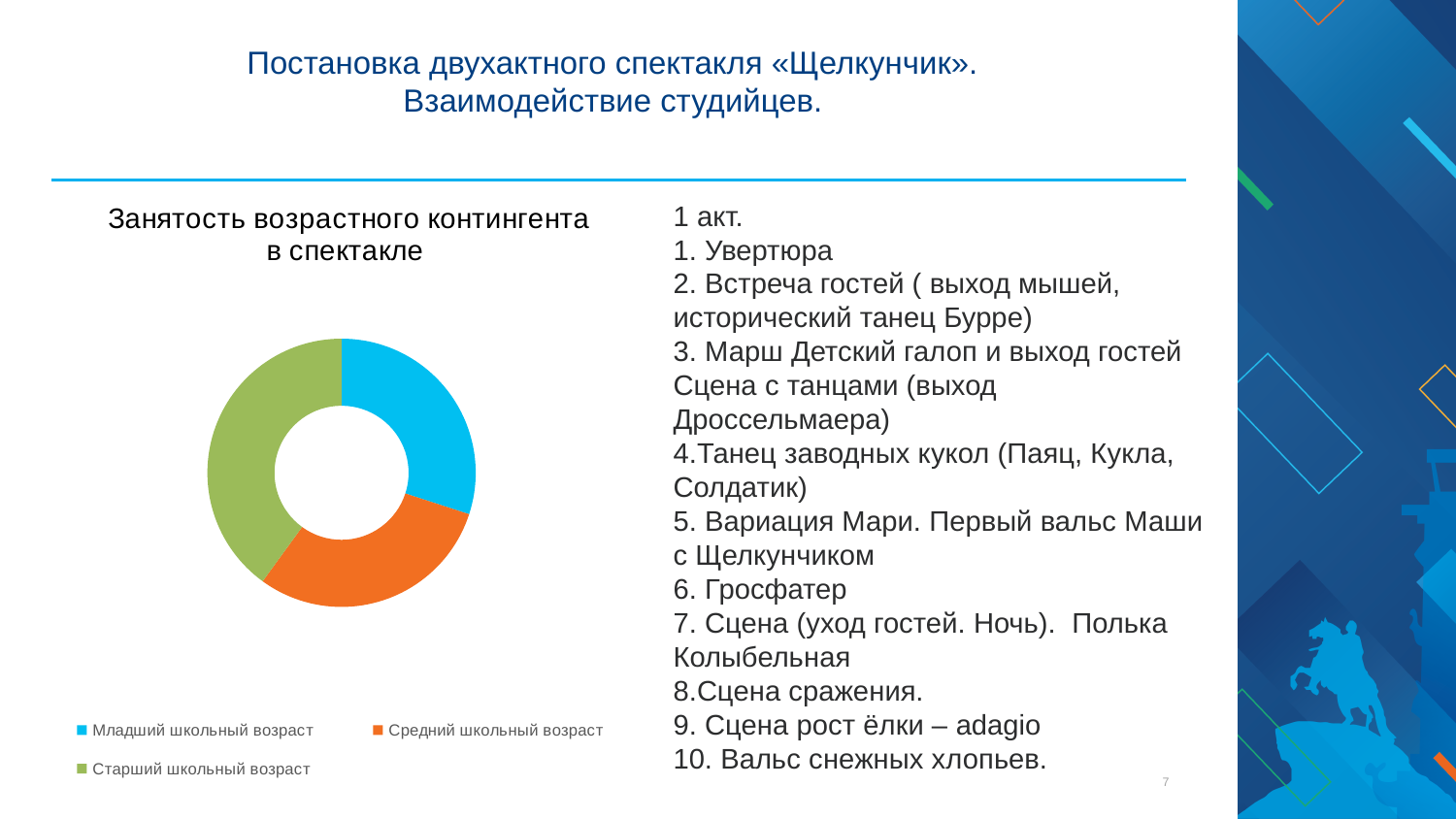
How many categories does the chart show? 3 Which is larger: the share for Старший школьный возраст or the share for Младший школьный возраст? Старший школьный возраст How many entries does the chart's legend list? 3 What kind of chart is shown on the slide? Doughnut chart Which age group has the largest share of the chart? Старший школьный возраст What is the title of the chart? Занятость возрастного контингента в спектакле Which is larger: the share for Старший школьный возраст or the share for Средний школьный возраст? Старший школьный возраст Which colour represents Средний школьный возраст in the chart? Orange